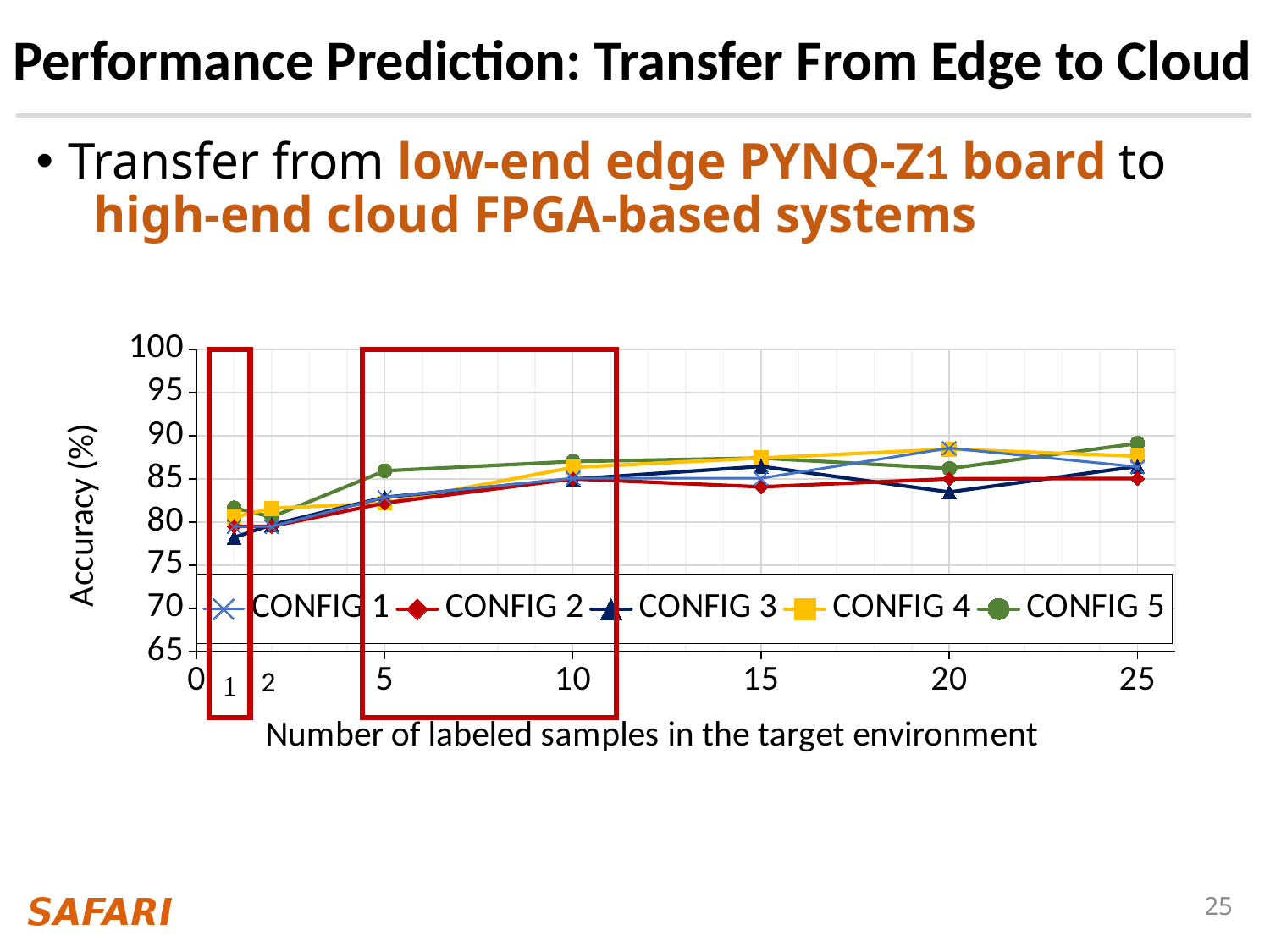
Is the accuracy for CONFIG 3 at 1 labeled sample greater or less than 80? less At 5 labeled samples, which config has the highest accuracy? CONFIG 5 At 20 labeled samples, which has the higher accuracy, CONFIG 1 or CONFIG 3? CONFIG 1 Does the accuracy of CONFIG 5 rise or fall from 1 to 10 labeled samples? rise How many data points are plotted for each series along the x axis? 7 At 1 labeled sample, which config has the lowest accuracy? CONFIG 3 What is the label of the y axis? Accuracy (%) How many series does the chart's legend list? 5 What kind of chart is shown on the slide? line chart Is the accuracy for CONFIG 3 at 20 labeled samples greater or less than 85? less What is the label of the x axis? Number of labeled samples in the target environment Is the accuracy for CONFIG 5 at 25 labeled samples greater or less than 85? greater